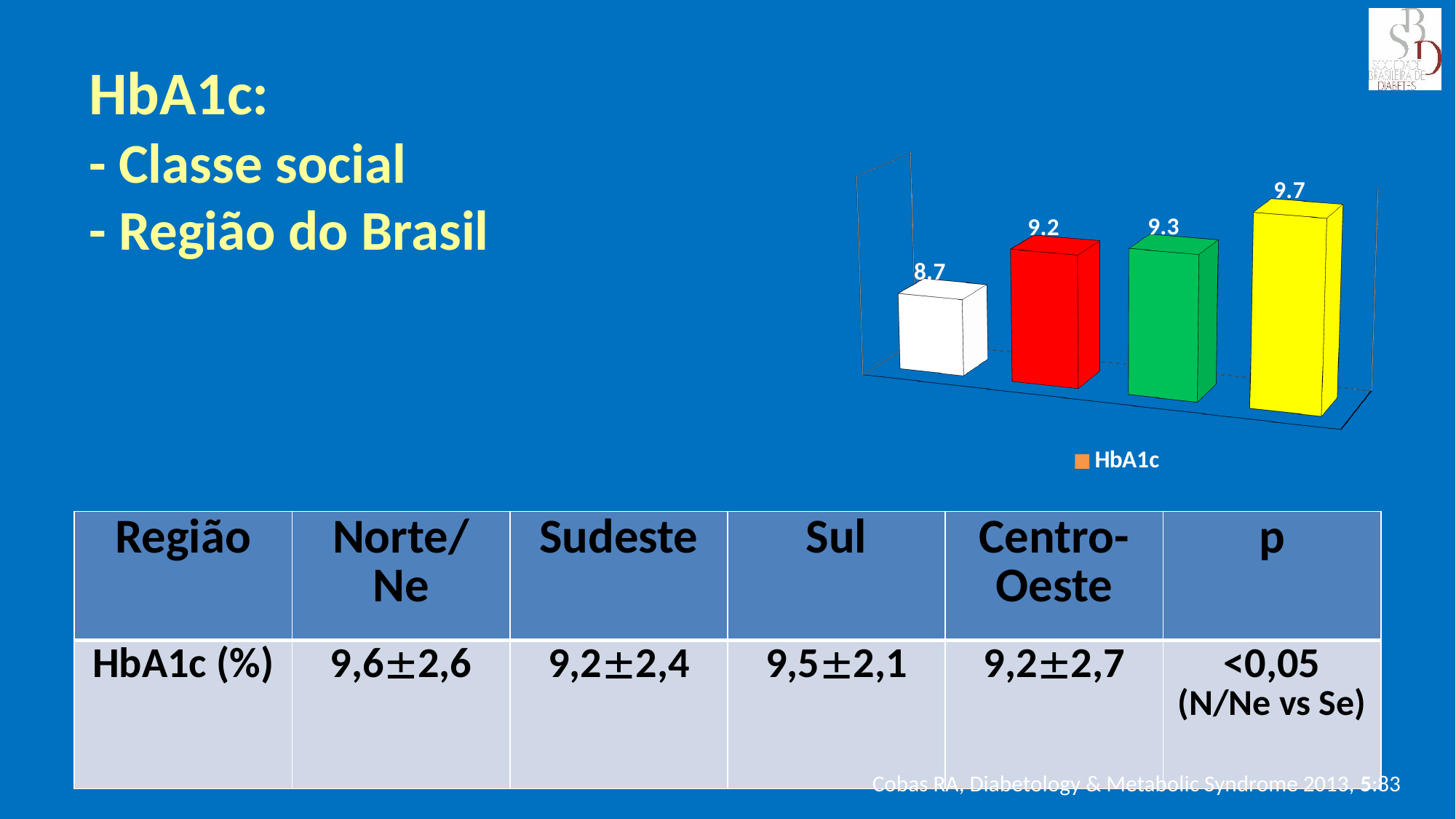
What is the highest value labelled in the chart? 9.7 What is the value shown on the green bar of the chart? 9.3 What is the lowest value labelled in the chart? 8.7 How many bars are plotted in the chart? 4 Do the bar values rise or fall from left to right in the chart? rise What is the value shown on the rightmost (yellow) bar of the chart? 9.7 What is the value shown on the red bar of the chart? 9.2 How many series does the chart legend list? 1 What is the value shown on the leftmost (white) bar of the chart? 8.7 What series name is shown in the chart legend? HbA1c What is the difference between the yellow bar and the white bar in the chart? 1.0 What kind of chart is shown on the slide? bar chart